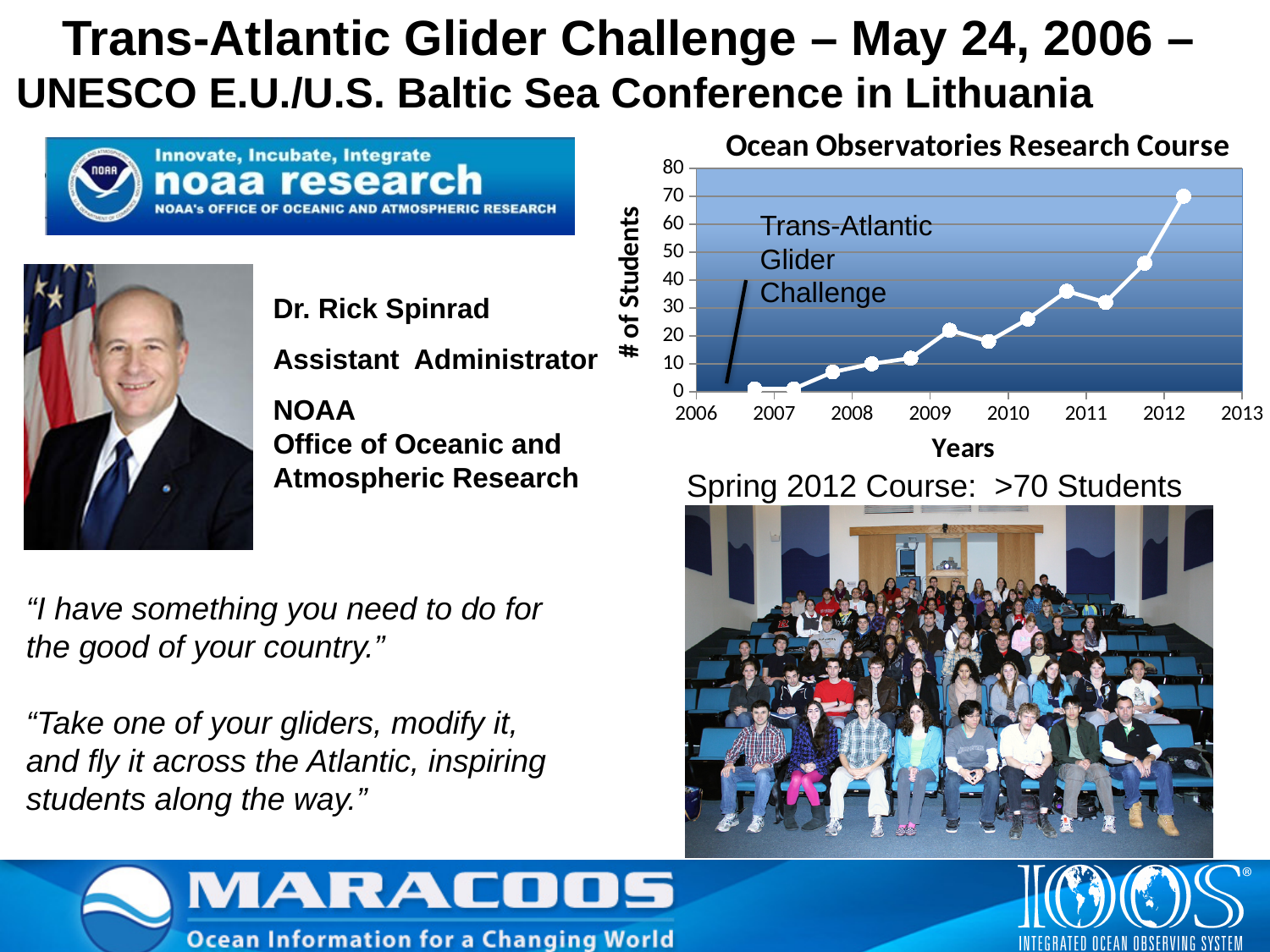
What is the label on the vertical axis of the chart? # of Students What kind of chart is shown on the slide? line chart Near which year on the x axis does the chart reach its highest value? 2012 Is the value of the first (leftmost) point on the chart greater or less than 10? less Is the highest point on the chart greater or less than 50? greater Do the values in the chart generally rise or fall from 2006 to 2012? rise Is the value of the last (rightmost) point on the chart greater or less than 60? greater How many data points are plotted on the line in the chart? 12 Which is larger: the value of the point just after the 2012 tick or the value of the point just after the 2011 tick? the point just after 2012 What is the title of the chart? Ocean Observatories Research Course